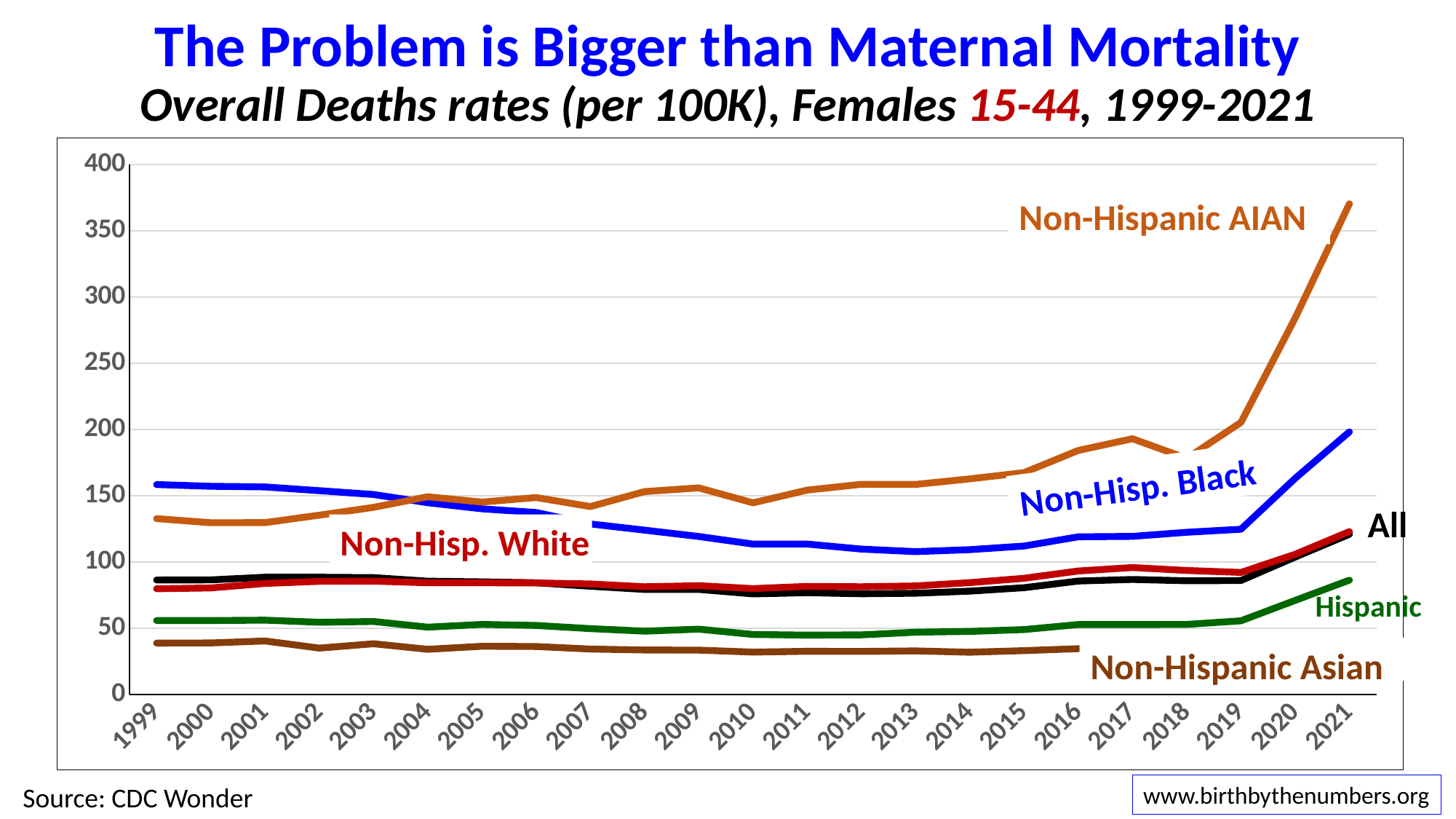
Is the value for Non-Hisp. Black in 1999 greater or less than 150? greater In which year does the Non-Hispanic Asian line end? 2016 How many series (lines) are plotted on the chart? 6 Which series has the highest death rate in 2021? Non-Hispanic AIAN Is the value for Non-Hispanic AIAN in 2021 greater or less than 350? greater Is the value for Non-Hispanic Asian in 2016 greater or less than 50? less Does the Non-Hispanic AIAN line rise or fall between 2018 and 2021? rise Which series has the lowest death rate in 1999? Non-Hispanic Asian What kind of chart is shown on the slide? line chart How many years are shown along the x axis of the chart? 23 In 1999, which is higher: Non-Hisp. Black or Non-Hispanic AIAN? Non-Hisp. Black